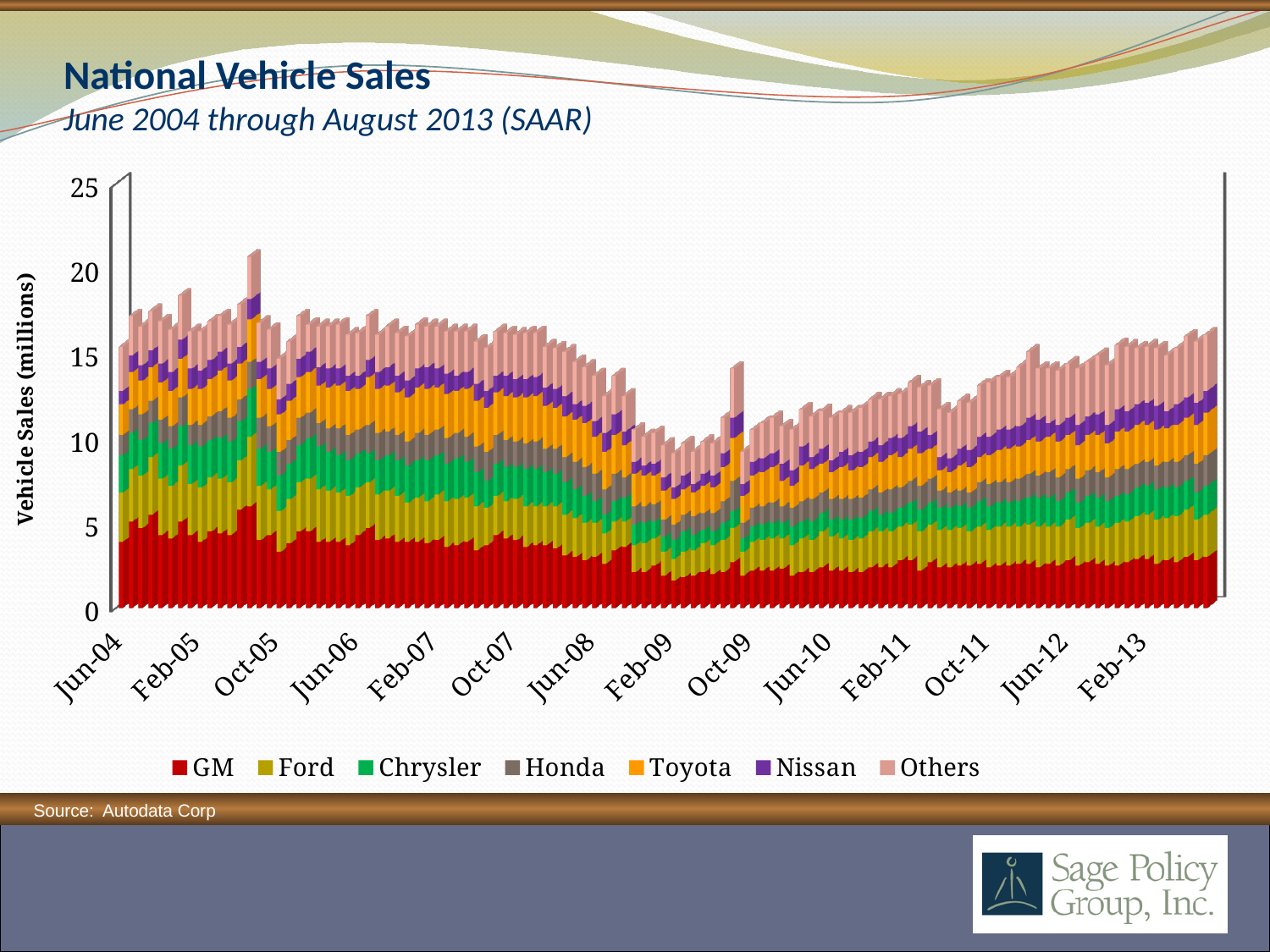
Do the bar totals generally rise or fall from Jun-10 to Feb-13? rise Which series is listed first in the legend? GM How many date labels are shown on the x axis? 14 Which series forms the bottom segment of each stacked bar? GM Is the total of the tallest bar (around late 2005) greater or less than 20? greater What is the title of the chart on the slide? National Vehicle Sales Which series forms the top segment of each stacked bar? Others How many series does the legend list? 7 What is the label on the vertical axis? Vehicle Sales (millions) Are the bar totals around Feb-07 greater or less than 15? greater What kind of chart is shown on the slide? Stacked bar chart Are the bar totals around Feb-09 greater or less than 15? less